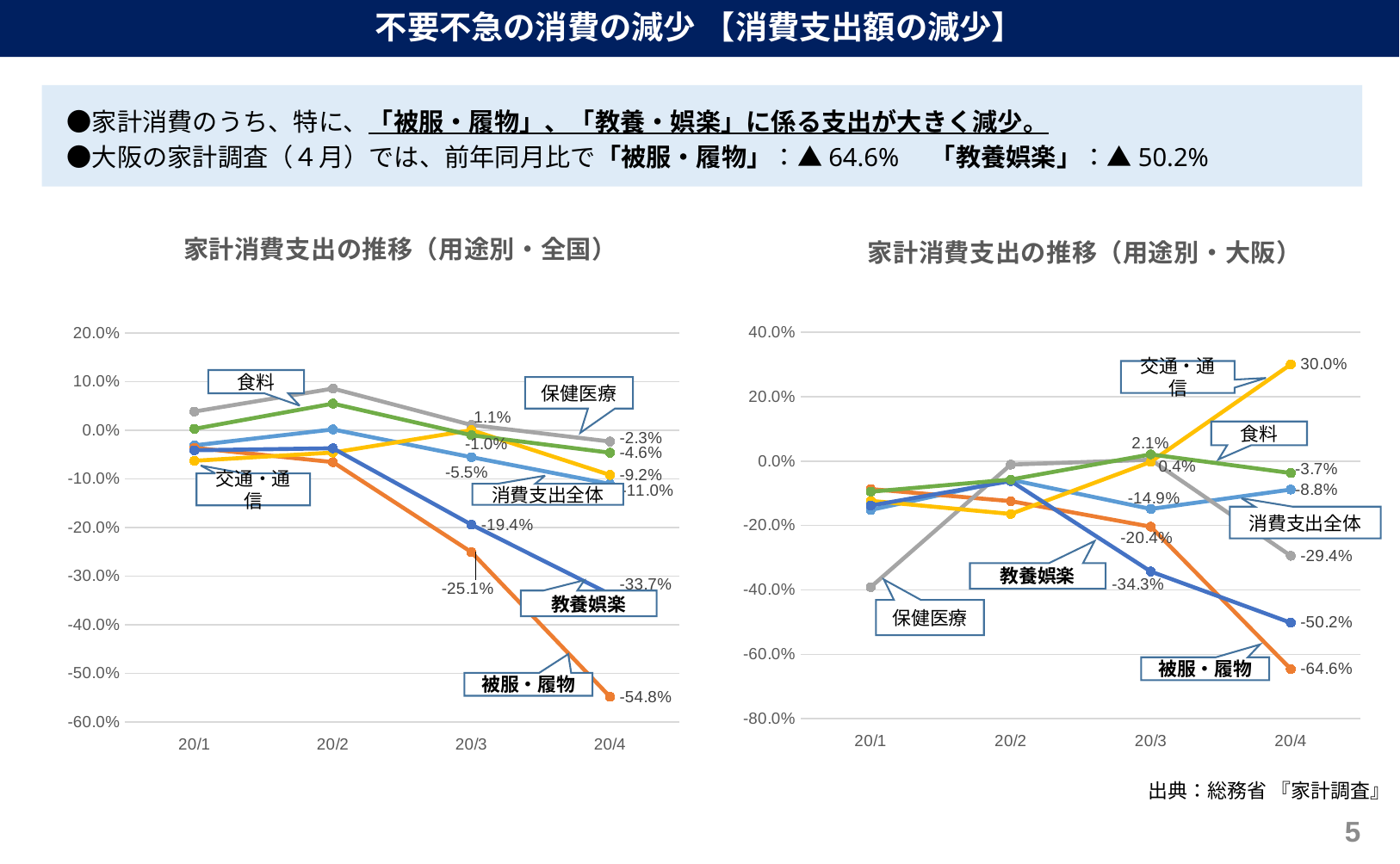
In the 家計消費支出の推移（用途別・大阪） chart, which series has the lowest value at 20/4? 被服・履物 In the 家計消費支出の推移（用途別・大阪） chart, what is the difference between the 被服・履物 values at 20/3 and 20/4? 44.2 percentage points In the 家計消費支出の推移（用途別・全国） chart, which series has the highest value at 20/4? 保健医療 In the 家計消費支出の推移（用途別・大阪） chart, what is the value for 交通・通信 at 20/4? 30.0% How many time points are shown on the x axis of the 家計消費支出の推移（用途別・全国） chart? 4 In the 家計消費支出の推移（用途別・大阪） chart, what is the value for 教養娯楽 at 20/4? -50.2% In the 家計消費支出の推移（用途別・大阪） chart, is the value for 保健医療 at 20/1 greater or less than -20.0%? less What kind of chart is 家計消費支出の推移（用途別・大阪）? Line chart In the 家計消費支出の推移（用途別・全国） chart, which is larger at 20/4: 食料 or 交通・通信? 食料 In the 家計消費支出の推移（用途別・全国） chart, does the 教養娯楽 line rise or fall from 20/2 to 20/4? Fall In the 家計消費支出の推移（用途別・全国） chart, what is the value for 教養娯楽 at 20/3? -19.4% In the 家計消費支出の推移（用途別・全国） chart, what is the value for 被服・履物 at 20/4? -54.8%